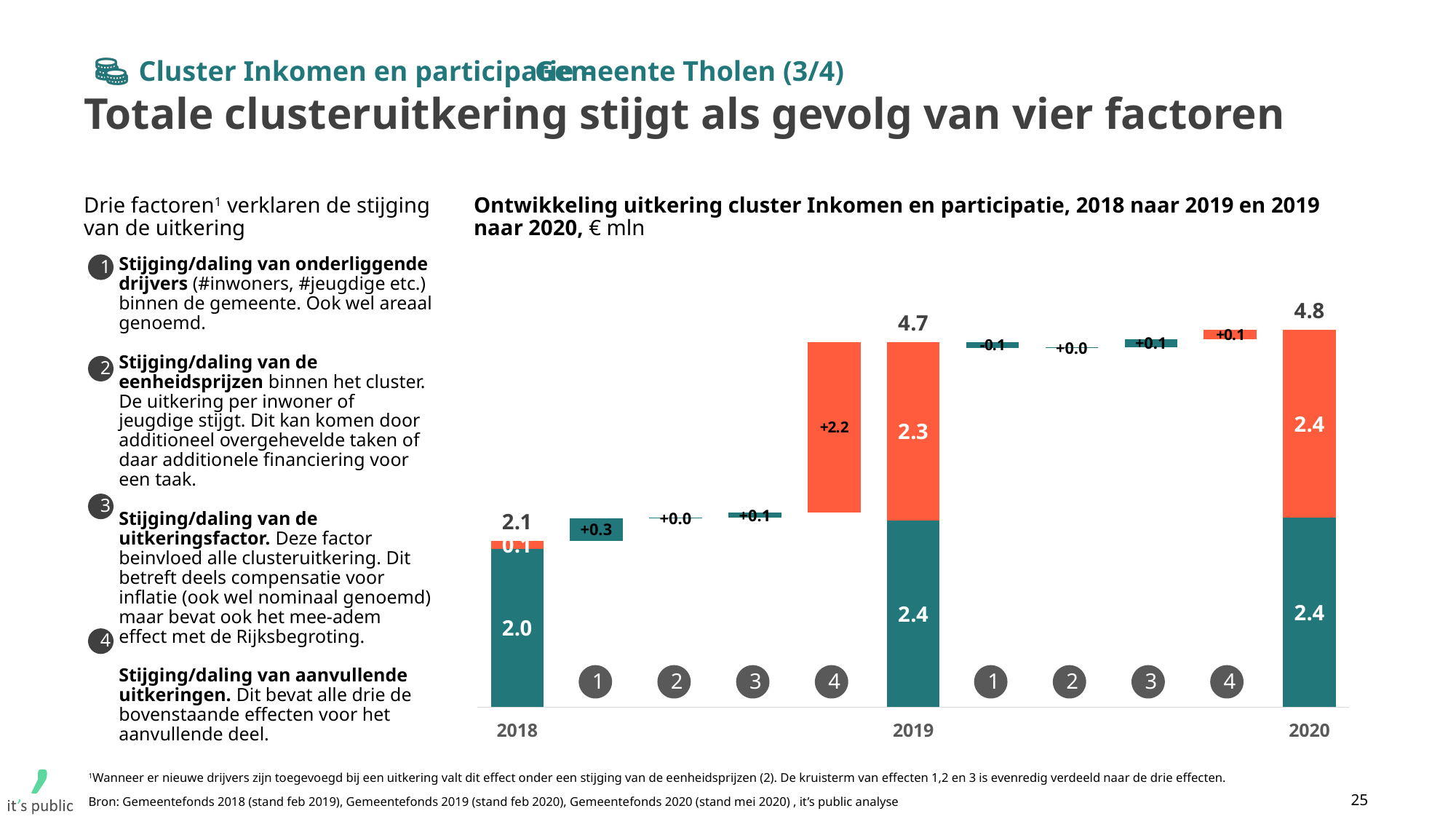
What is the total value shown above the 2020 bar? 4.8 What is the total value shown above the 2019 bar? 4.7 What is the total value shown above the 2018 bar? 2.1 Is the total for 2019 larger or smaller than the total for 2020? smaller What is the value of the step labelled 4 between 2018 and 2019? +2.2 Which year has the highest total value? 2020 What is the value of the step labelled 1 between 2018 and 2019? +0.3 What is the value of the step labelled 1 between 2019 and 2020? -0.1 What is the difference between the 2019 total and the 2018 total? 2.6 Do the year totals rise or fall from 2018 to 2020? rise How many year totals (2018, 2019, 2020) are shown as full bars in the chart? 3 What is the value of the teal (lower) segment of the 2019 bar? 2.4